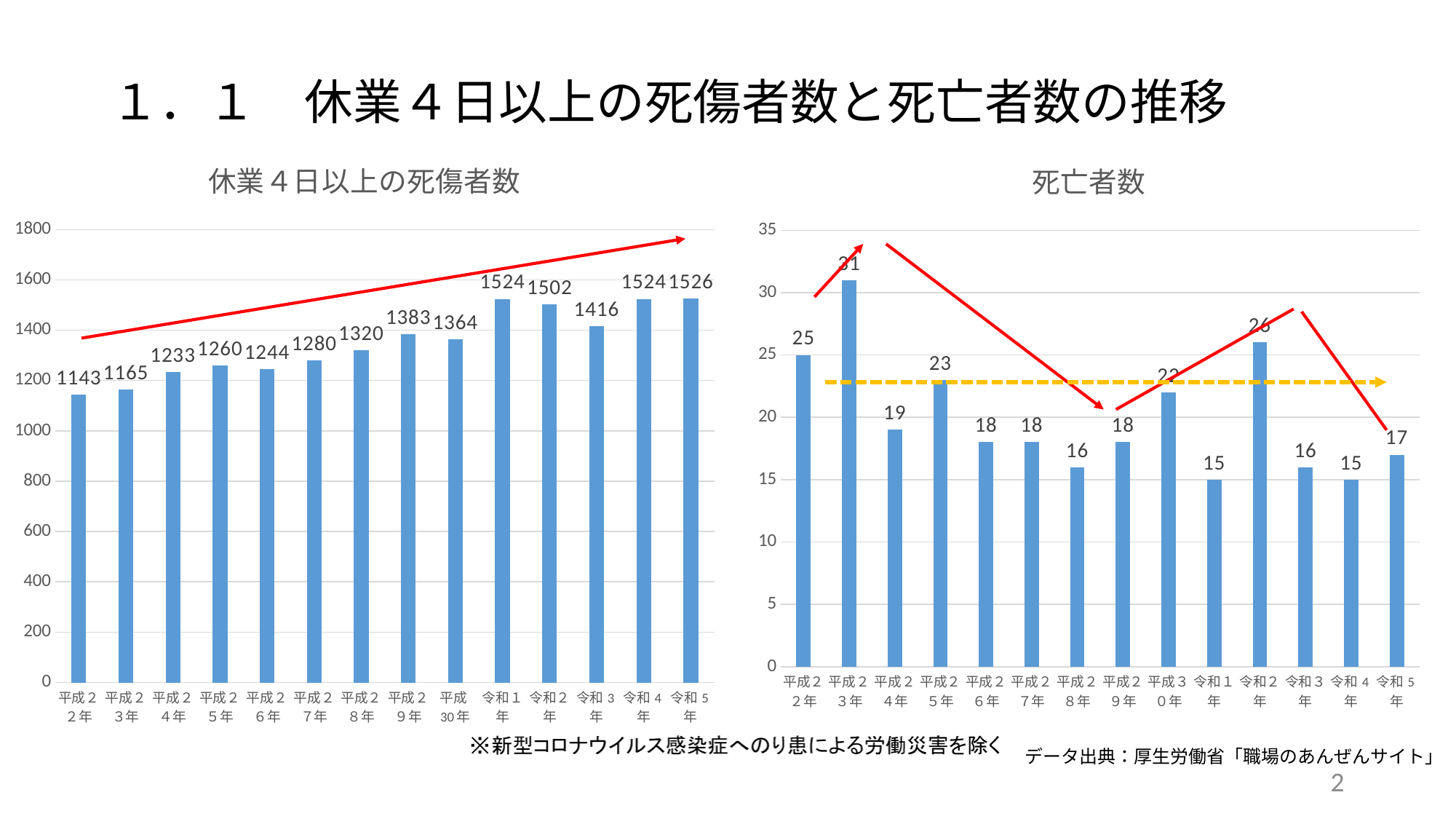
In the 死亡者数 chart, what is the value for 平成23年? 31 In the 休業４日以上の死傷者数 chart, how many years are shown on the x axis? 14 In the 死亡者数 chart, which year has the highest value? 平成23年 In the 死亡者数 chart, which is larger, the value for 令和2年 or the value for 令和3年? 令和2年 In the 休業４日以上の死傷者数 chart, which year has the lowest value? 平成22年 In the 死亡者数 chart, what is the difference between the values for 平成23年 and 平成24年? 12 In the 休業４日以上の死傷者数 chart, what is the difference between the values for 令和5年 and 平成22年? 383 In the 休業４日以上の死傷者数 chart, what is the value for 平成22年? 1143 In the 死亡者数 chart, what is the value for 令和5年? 17 In the 休業４日以上の死傷者数 chart, what is the value for 令和3年? 1416 In the 休業４日以上の死傷者数 chart, which year has the highest value? 令和5年 What kind of chart is the 死亡者数 chart? Bar chart